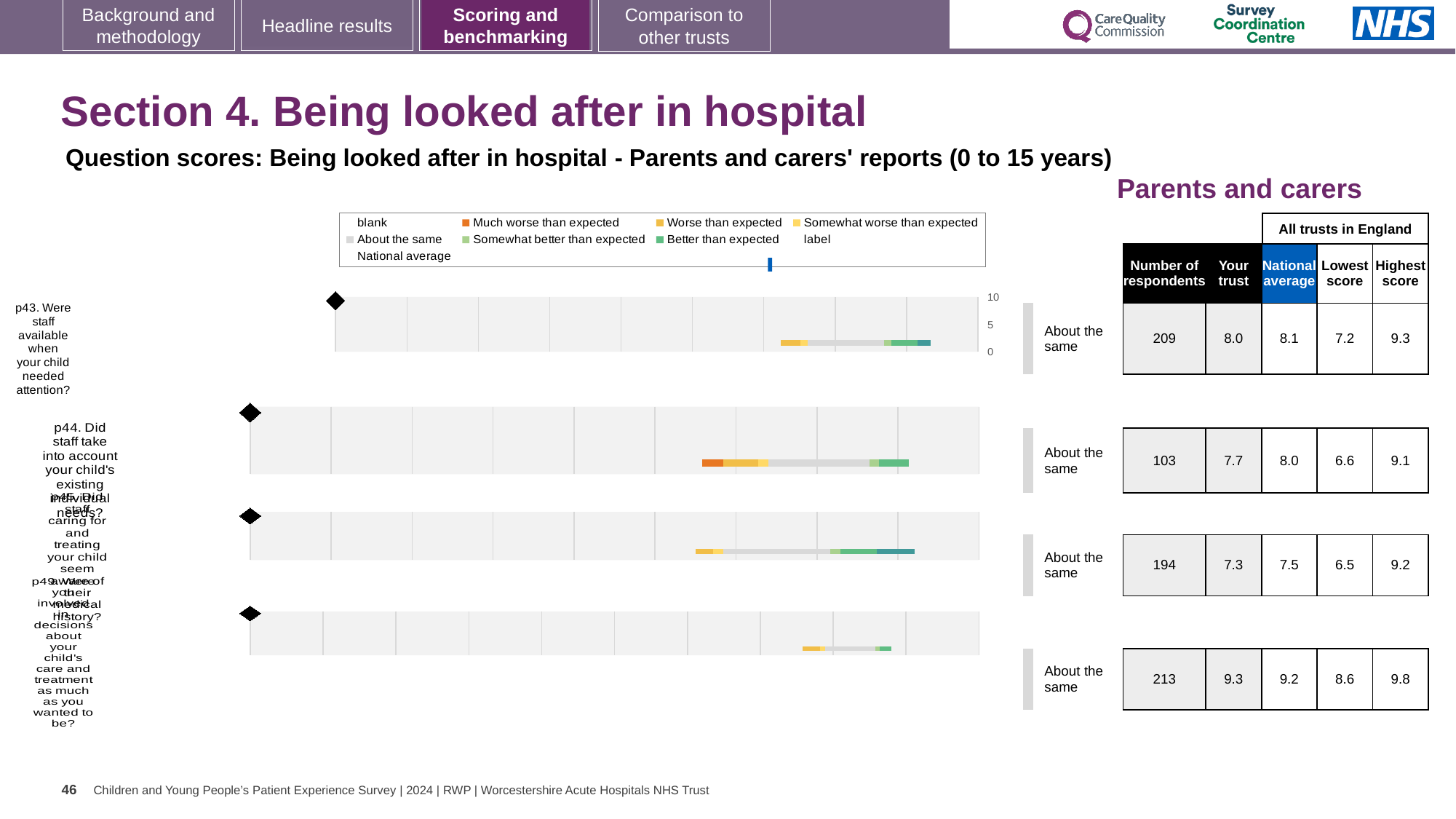
For p43, what is the difference between the highest score (9.3) and the lowest score (7.2) across all trusts in England? 2.1 What colour does the legend use for 'Much worse than expected'? Orange Which question has the lowest 'Your trust' score? p45 What kind of chart is used to show the question scores on this slide? bar chart What is the 'Your trust' score for p43 (Were staff available when your child needed attention?)? 8.0 What is the national average score for p44 (Did staff take into account your child's existing individual needs?)? 8.0 How many respondents are listed for p49? 213 How many survey questions (rows) are plotted in the chart? 4 What is the lowest score across all trusts in England for p45? 6.5 For p43, which is larger: the 'Your trust' score or the national average? National average What benchmark category is shown next to each of the four questions? About the same Which question has the highest 'Your trust' score? p49